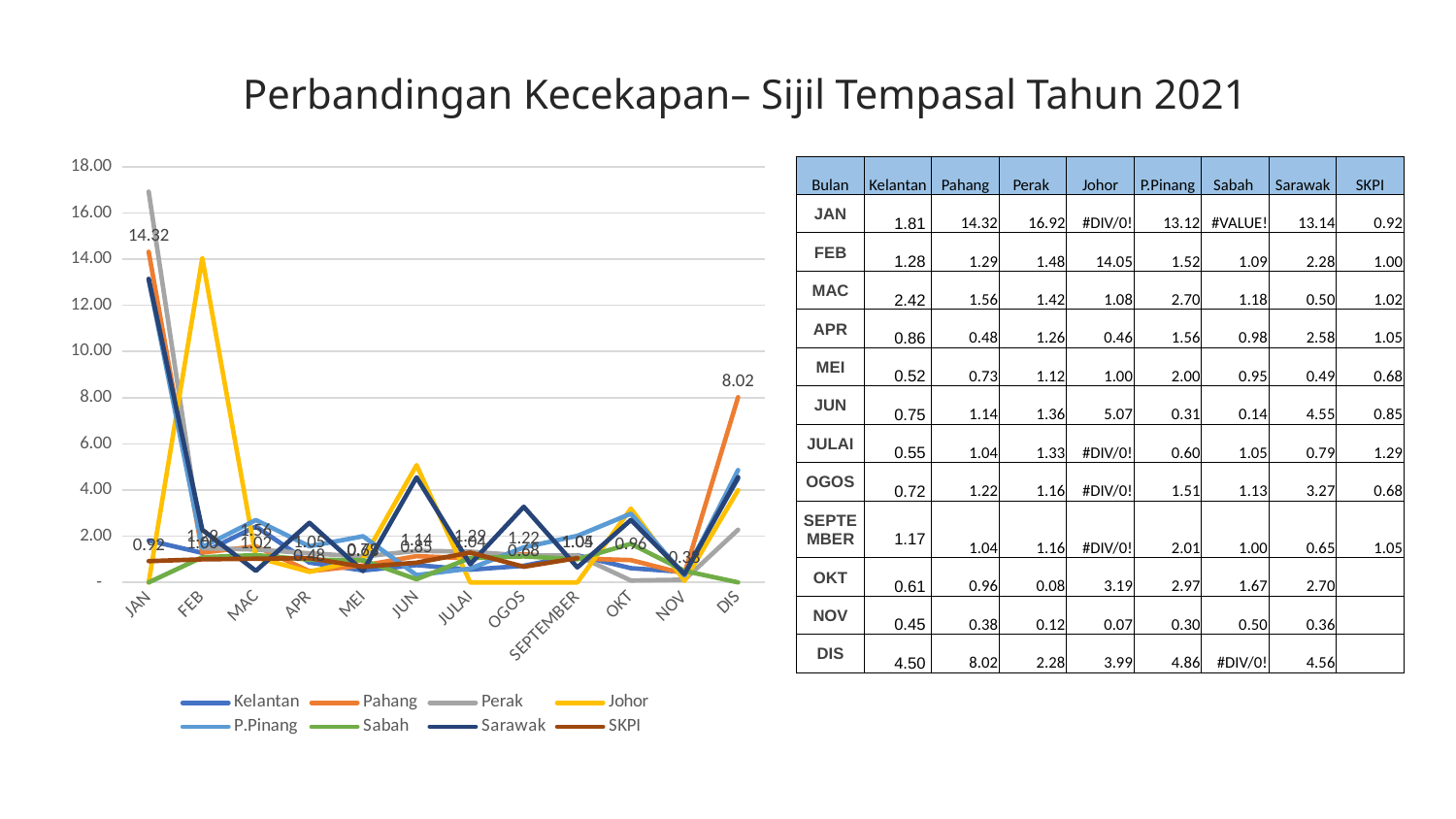
What is the title of the chart? Perbandingan Kecekapan– Sijil Tempasal Tahun 2021 What is the value for Pahang in DIS? 8.02 Is the value for Johor in FEB greater or less than 12.00? greater Is the value for Perak in JAN greater or less than 16.00? greater What type of chart is shown on the slide? line chart Between NOV and DIS, does the Pahang line rise or fall? rise In JAN, which is higher: Perak or Pahang? Perak What is the difference between the Pahang value in JAN and the Pahang value in DIS? 6.30 What is the value for Pahang in JAN? 14.32 How many series does the chart legend list? 8 How many months are plotted along the x axis of the chart? 12 In which month does Pahang reach its highest value? JAN